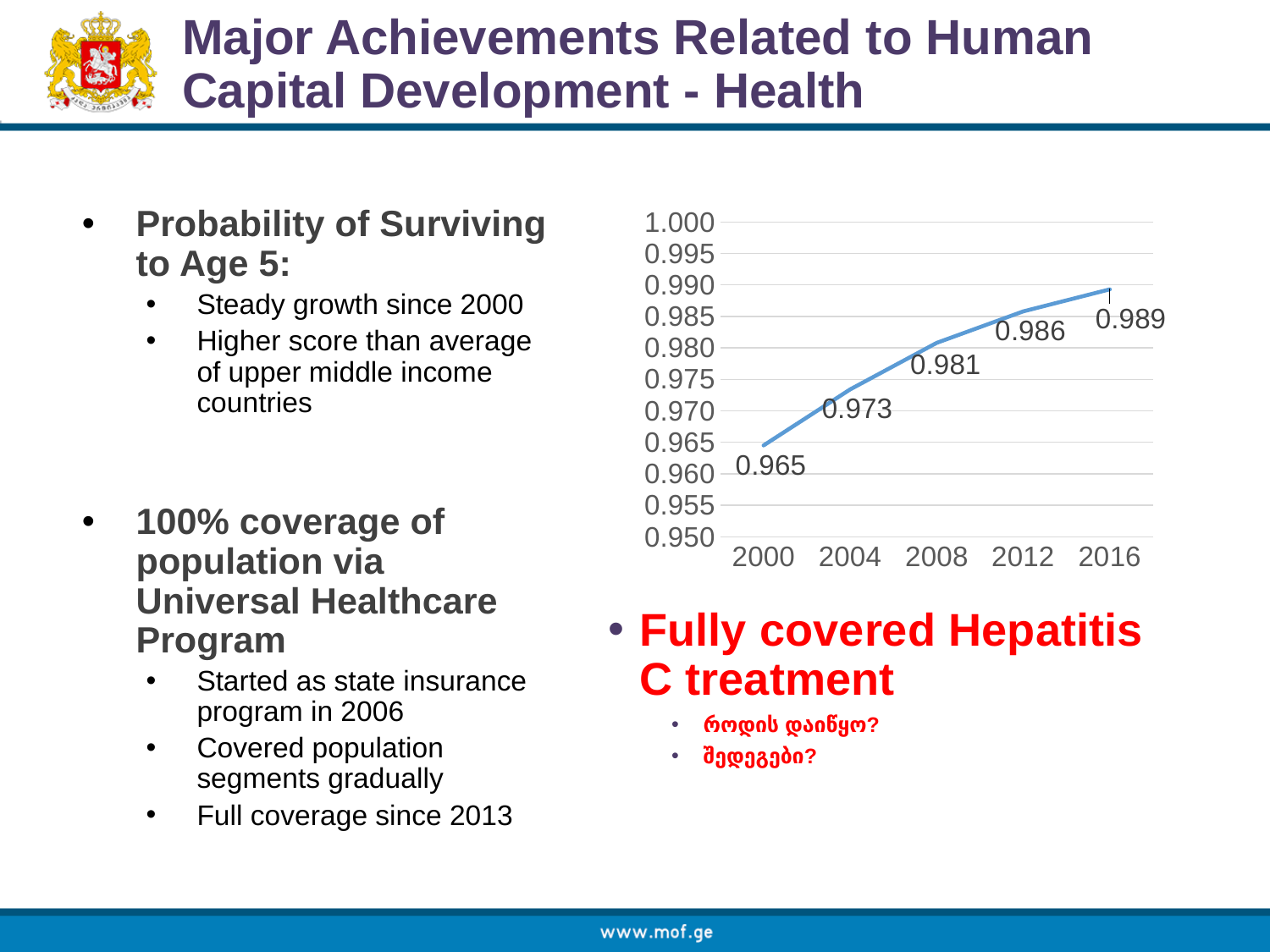
What is the value plotted for 2008? 0.981 What is the value plotted for 2016? 0.989 How many data points are labelled on the line? 5 What is the difference between the values for 2016 and 2000? 0.024 Which year has the lowest plotted value? 2000 Which year has the highest plotted value? 2016 What is the value plotted for 2000? 0.965 What kind of chart is shown on the slide? line chart What is the value plotted for 2012? 0.986 Is the value for 2004 greater or less than 0.970? greater Do the plotted values rise or fall from 2000 to 2016? rise Which is larger, the value for 2004 or the value for 2008? 2008